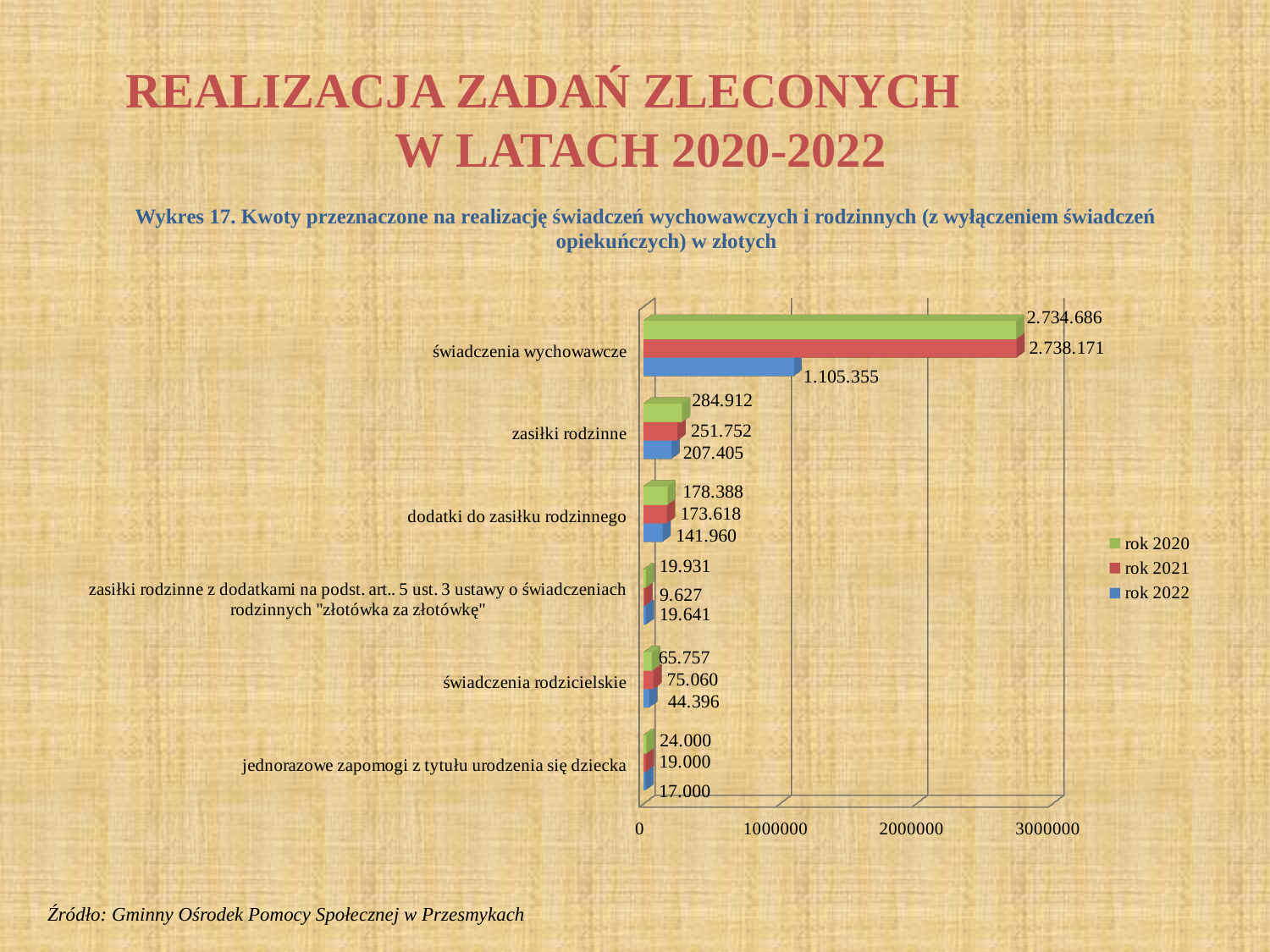
What is the value for zasiłki rodzinne in rok 2020? 284.912 What is the value for świadczenia rodzicielskie in rok 2021? 75.060 Which category has the highest value in rok 2022? świadczenia wychowawcze How many categories are shown on the chart? 6 What kind of chart is shown on the slide? bar chart Which colour represents rok 2021 in the legend? red Which is larger for dodatki do zasiłku rodzinnego: the rok 2020 value or the rok 2022 value? rok 2020 What is the value for świadczenia wychowawcze in rok 2022? 1.105.355 What is the value for jednorazowe zapomogi z tytułu urodzenia się dziecka in rok 2022? 17.000 What is the difference between the rok 2020 and rok 2022 values for zasiłki rodzinne? 77.507 How many series does the legend list? 3 Which category has the lowest value in rok 2021? zasiłki rodzinne z dodatkami na podst. art.. 5 ust. 3 ustawy o świadczeniach rodzinnych "złotówka za złotówkę"